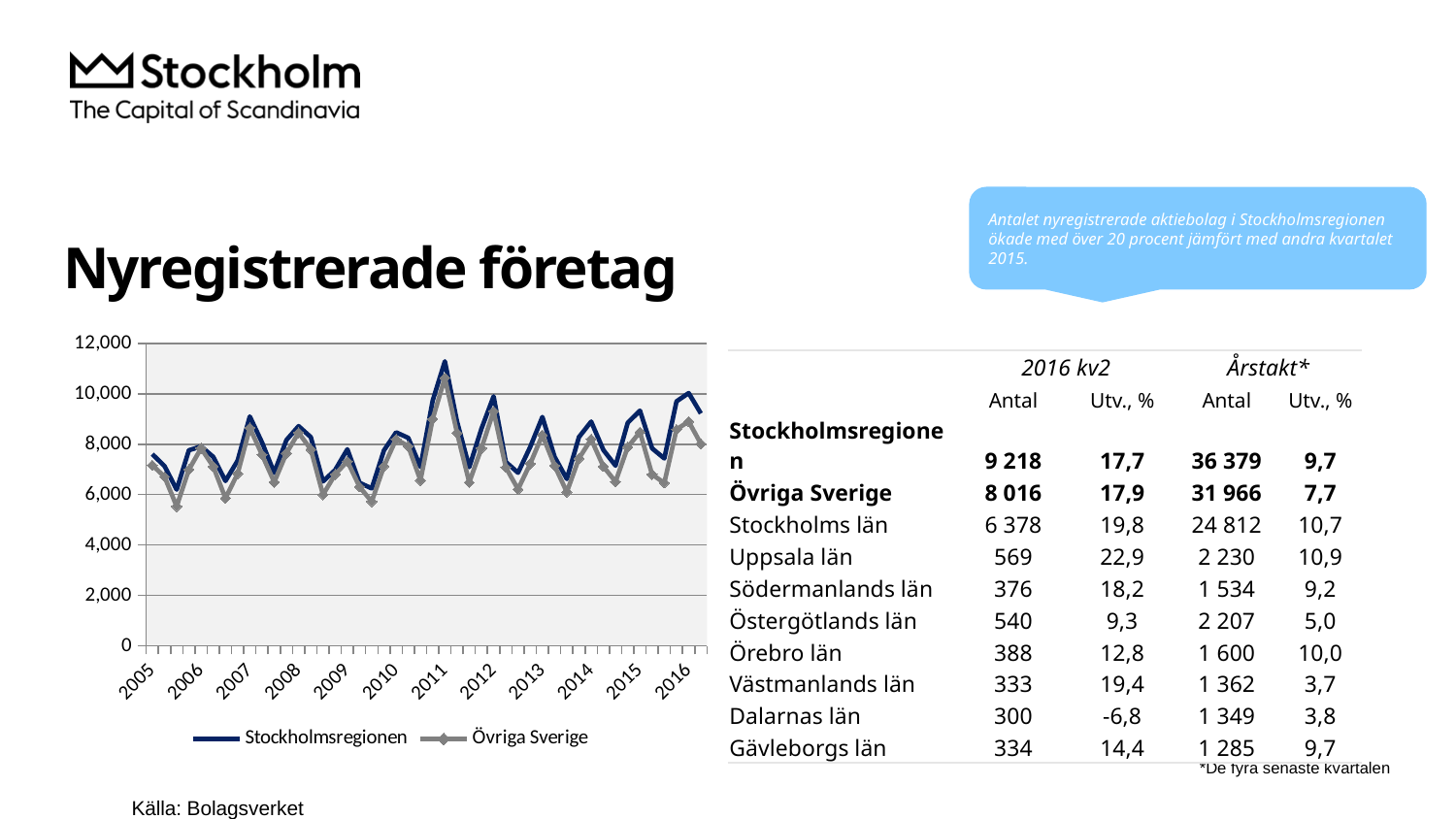
What kind of chart is shown on the slide? line chart How many series does the chart legend list? 2 How many years are labelled on the x axis of the chart? 12 Is the peak value of the Stockholmsregionen series around 2011 greater or less than 10,000? greater What is the first year labelled on the x axis of the chart? 2005 What colour is the Stockholmsregionen line in the chart? dark blue What is the last year labelled on the x axis of the chart? 2016 At the 2011 peak, which series has the higher value, Stockholmsregionen or Övriga Sverige? Stockholmsregionen Which two series are shown in the chart legend? Stockholmsregionen and Övriga Sverige Is the lowest value of the Övriga Sverige series in 2005 greater or less than 6,000? less Which series is generally higher across the chart, Stockholmsregionen or Övriga Sverige? Stockholmsregionen What is the highest value shown on the y axis of the chart? 12,000